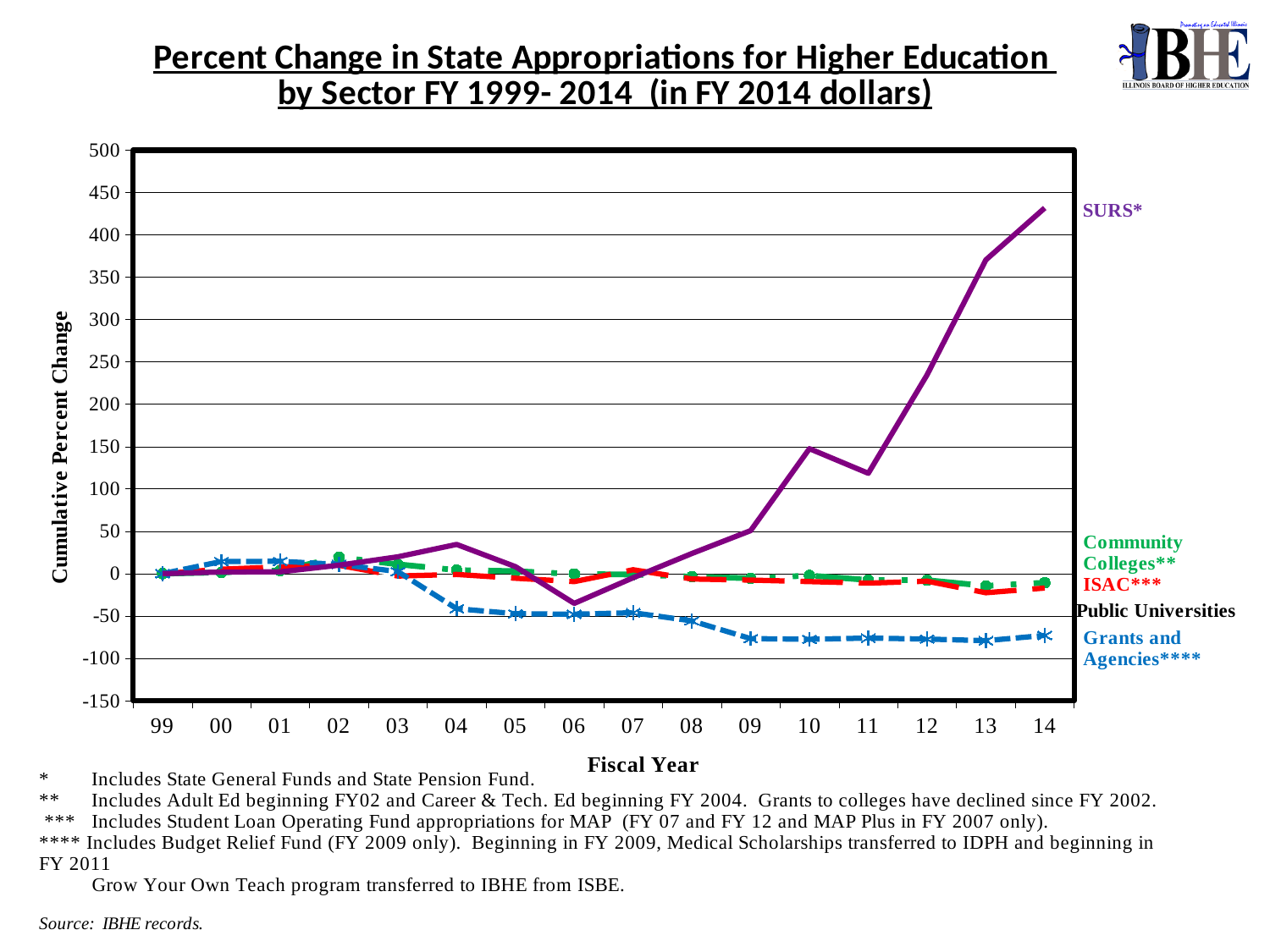
Which series has the highest value in FY 14? SURS* How many fiscal years are plotted along the x axis? 16 Is the value for SURS* in FY 06 greater or less than 0? less Which series has the lowest value in FY 14? Grants and Agencies**** Is the value for SURS* in FY 10 greater or less than 100? greater Does the SURS* line rise or fall from FY 09 to FY 14? rise How many series are labelled on the chart? 5 What kind of chart is shown on the slide? line chart Is the value for SURS* in FY 14 greater or less than 400? greater What is the title of the y axis? Cumulative Percent Change Does the Grants and Agencies**** line rise or fall from FY 03 to FY 09? fall